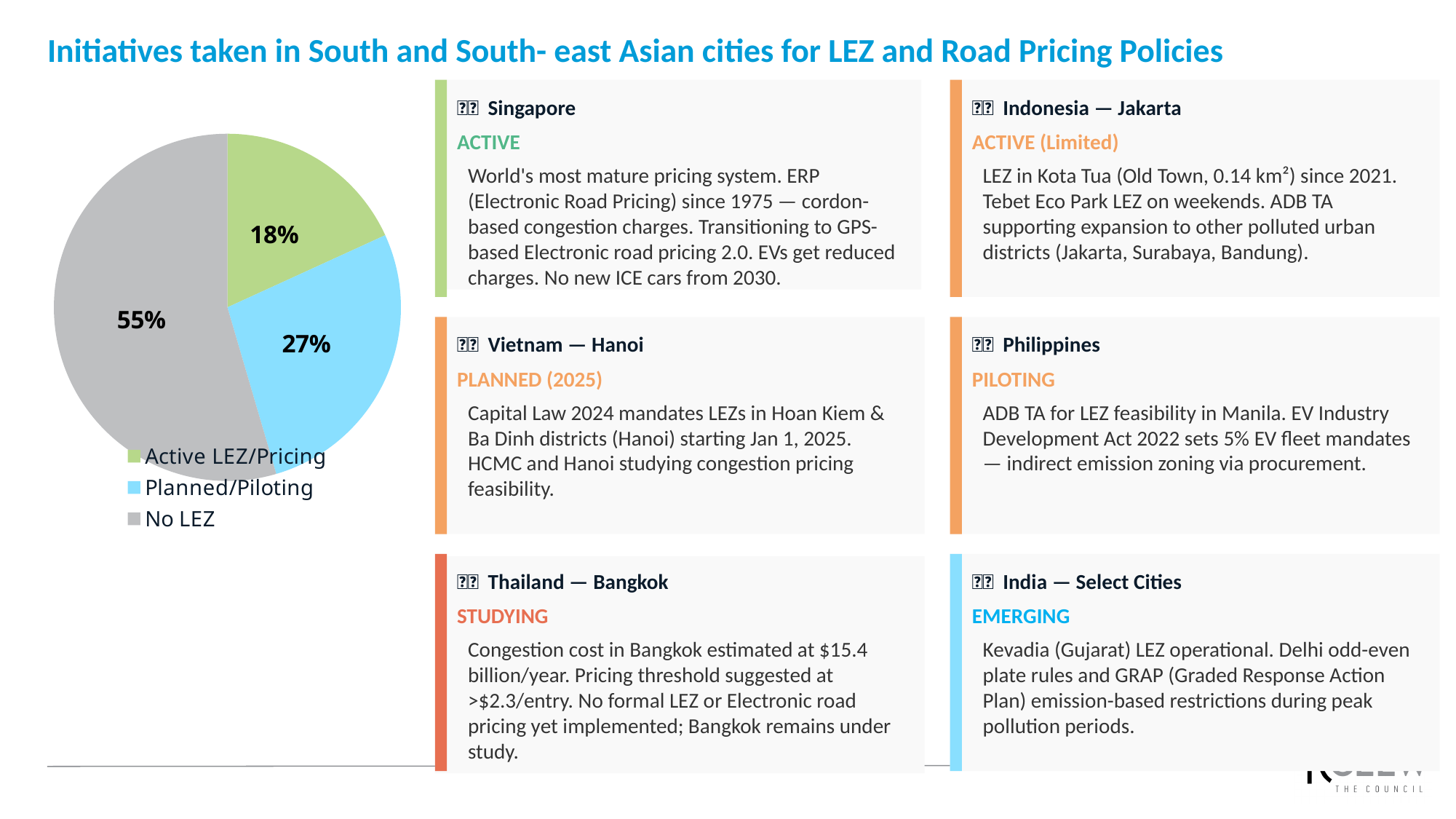
What kind of chart is shown on the slide? Pie chart What is the difference in percentage points between the "No LEZ" slice and the "Planned/Piloting" slice? 28 What share of the pie is labelled "No LEZ"? 55% Which category has the smallest slice of the pie? Active LEZ/Pricing What is the difference in percentage points between the "Planned/Piloting" slice and the "Active LEZ/Pricing" slice? 9 Which category has the largest slice of the pie? No LEZ What share of the pie is labelled "Planned/Piloting"? 27% Which is larger: the "Planned/Piloting" slice or the "Active LEZ/Pricing" slice? Planned/Piloting What colour is the "No LEZ" slice in the pie chart? Grey Which legend entry is shown in green? Active LEZ/Pricing How many categories does the pie chart show? 3 What share of the pie is labelled "Active LEZ/Pricing"? 18%